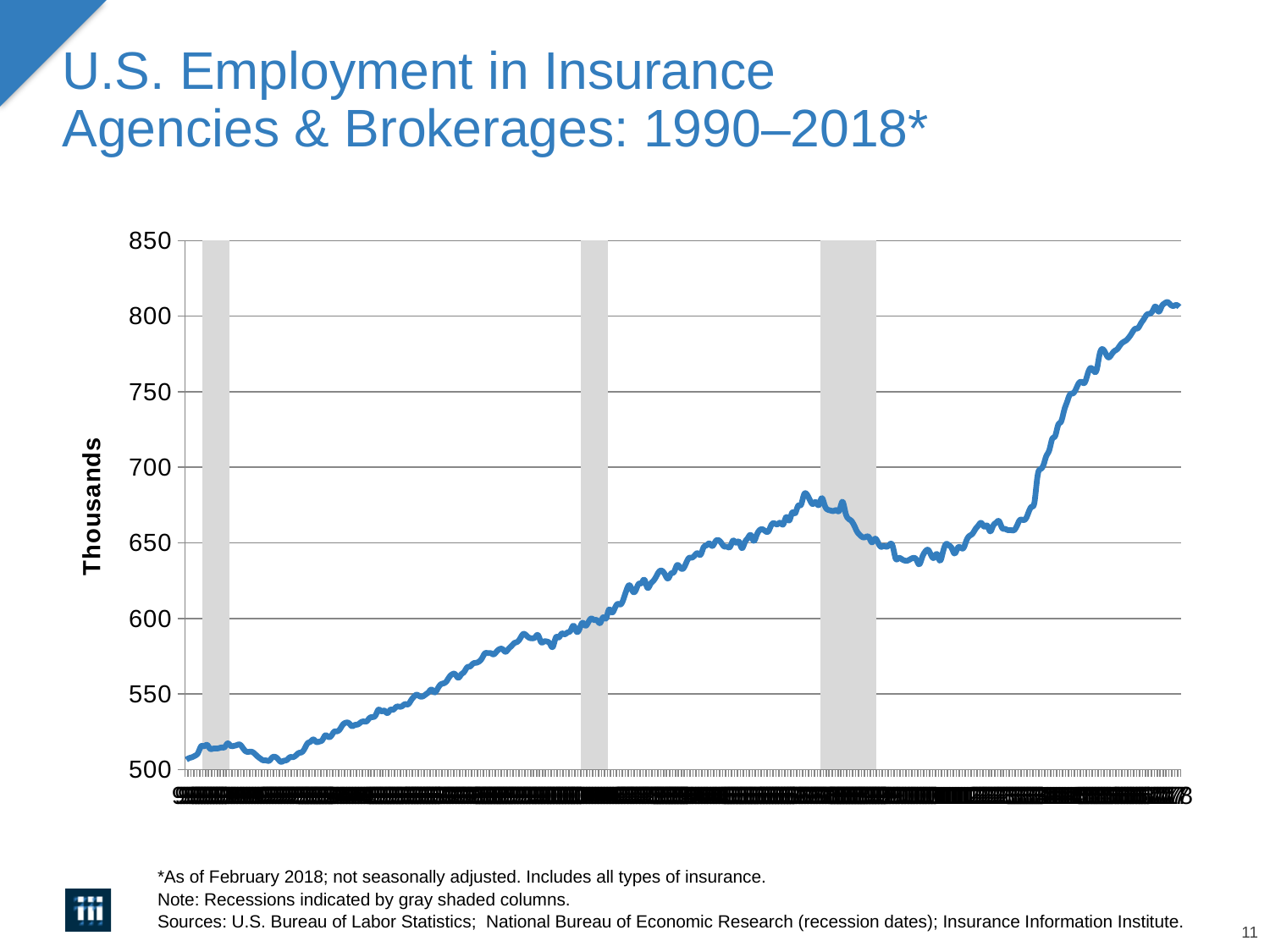
Is the value at the right-hand end of the line greater or less than 800? greater Is the value of the line at the end of the second gray shaded column greater or less than 650? less What is the title of the chart on the slide? U.S. Employment in Insurance Agencies & Brokerages: 1990–2018* Overall, do the values on the line rise or fall from the left of the x axis to the right? rise What is the label on the vertical axis of the chart? Thousands Is the value at the left-hand start of the line greater or less than 550? less What kind of chart is shown on the slide? line chart What is the highest value shown on the vertical axis of the chart? 850